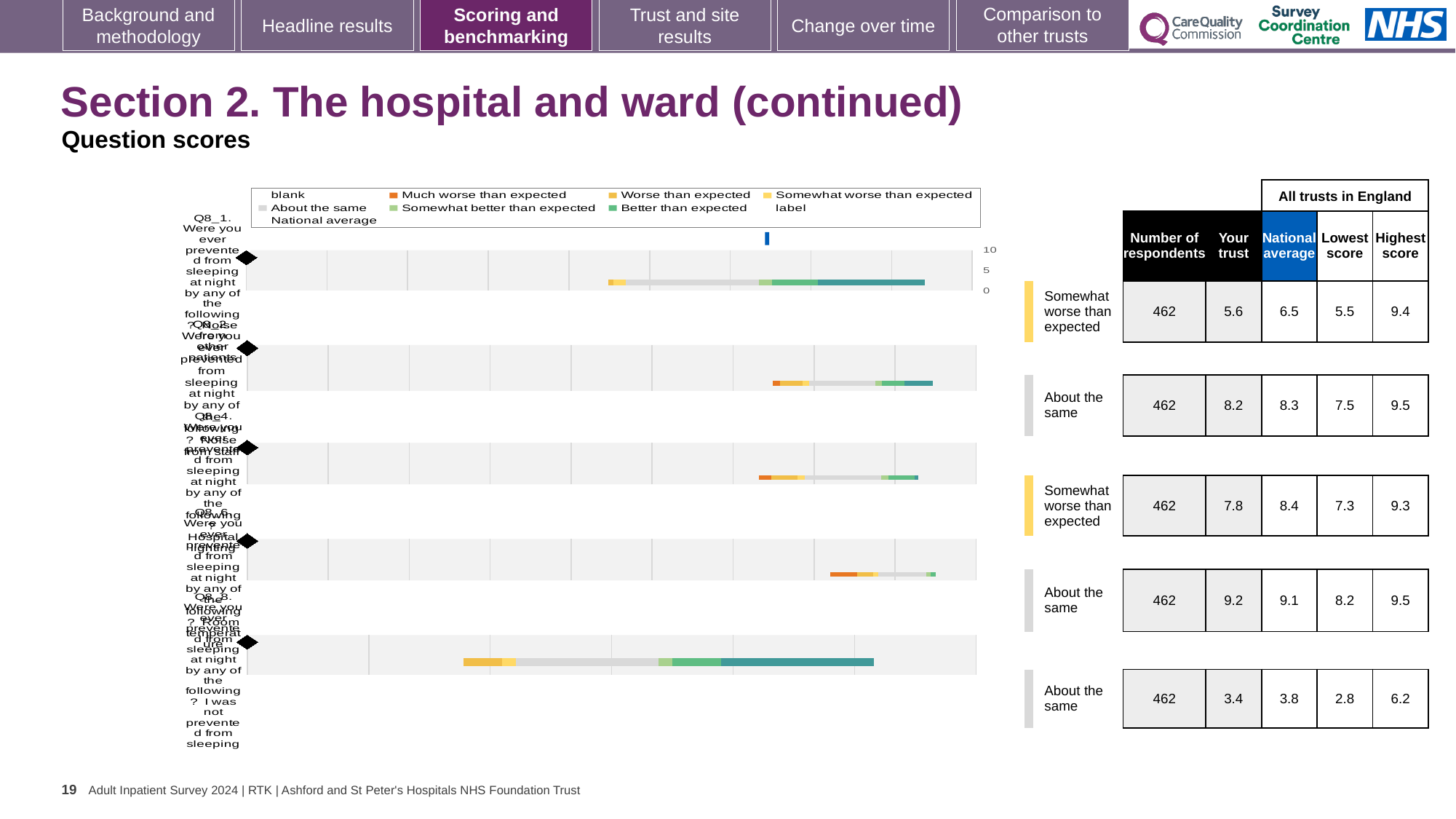
In the table beside the chart, what is the 'Your trust' score for the top row? 5.6 How many question rows (bars) does the chart show? 5 In the table beside the chart, which row has the highest 'Your trust' score? the fourth row (9.2) In the table beside the chart, which row has the lowest 'Your trust' score? the bottom row (3.4) In the table beside the chart, what is the 'National average' for the bottom row? 3.8 In the table beside the chart, is the 'Your trust' score or the 'National average' larger for the fourth row? Your trust (9.2) In the chart legend, what colour is used for 'Better than expected'? teal In the table beside the chart, what is the number of respondents for the second row? 462 In the table beside the chart, what is the difference between the highest score and the lowest score for the top row? 3.9 Is the trust score marker for the bottom bar of the chart greater or less than 5? less In the chart legend, what colour is used for 'Much worse than expected'? orange What kind of chart is shown on the slide? bar chart